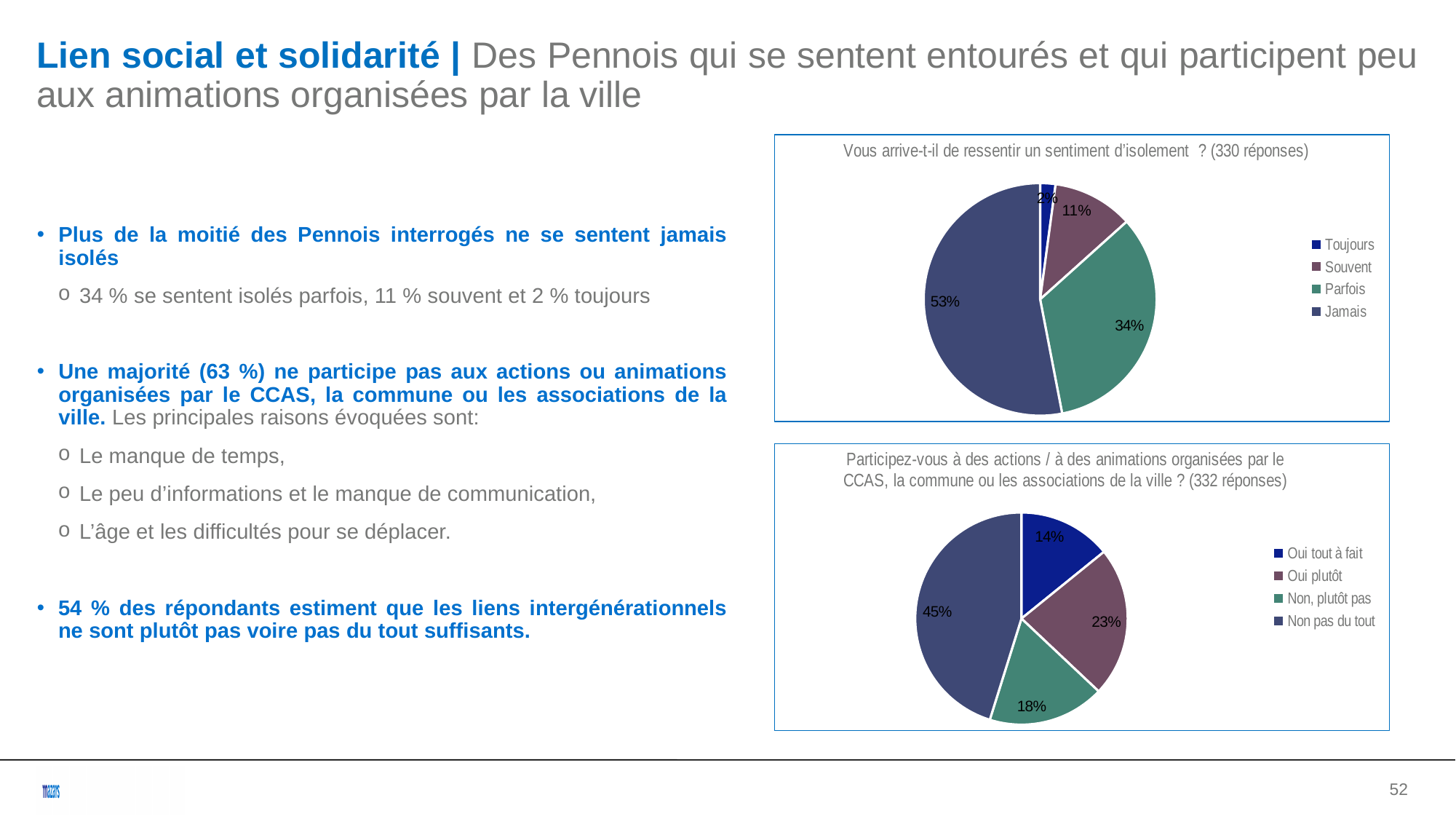
In the bottom chart ("Participez-vous à des actions / à des animations..."), what share of respondents answered "Non pas du tout"? 45% In the top chart ("Vous arrive-t-il de ressentir un sentiment d'isolement ?"), how many response categories does the legend list? 4 In the top chart ("Vous arrive-t-il de ressentir un sentiment d'isolement ?"), what share of respondents answered "Souvent"? 11% In the top chart ("Vous arrive-t-il de ressentir un sentiment d'isolement ?"), what share of respondents answered "Jamais"? 53% In the bottom chart ("Participez-vous à des actions / à des animations..."), what share of respondents answered "Oui tout à fait"? 14% In the top chart ("Vous arrive-t-il de ressentir un sentiment d'isolement ?"), which response has the largest share? Jamais In the top chart ("Vous arrive-t-il de ressentir un sentiment d'isolement ?"), which response has the smallest share? Toujours In the top chart ("Vous arrive-t-il de ressentir un sentiment d'isolement ?"), what is the difference in percentage points between "Jamais" and "Parfois"? 19 percentage points In the bottom chart ("Participez-vous à des actions / à des animations..."), what is the combined share of "Oui tout à fait" and "Oui plutôt"? 37% In the bottom chart ("Participez-vous à des actions / à des animations..."), which is larger: "Oui plutôt" or "Non, plutôt pas"? Oui plutôt What type of chart is the bottom chart ("Participez-vous à des actions / à des animations...")? Pie chart How many responses does the title of the bottom chart ("Participez-vous à des actions / à des animations...") say were collected? 332 réponses